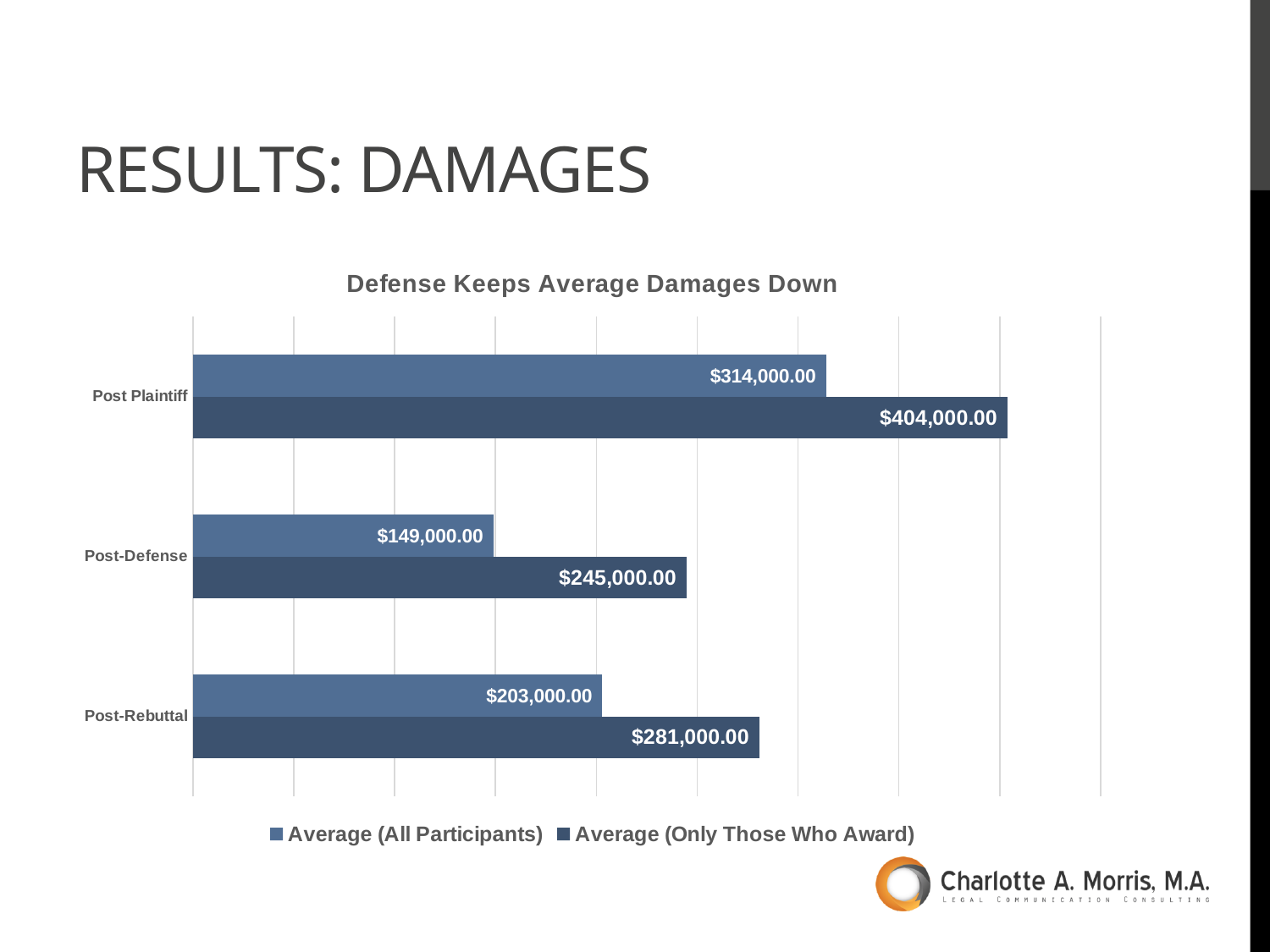
What is the difference between the Average (All Participants) values for Post-Rebuttal and Post-Defense? $54,000.00 What is the difference between the Average (Only Those Who Award) and Average (All Participants) values for Post Plaintiff? $90,000.00 Which category has the highest Average (Only Those Who Award) value? Post Plaintiff What is the Average (All Participants) value for Post-Rebuttal? $203,000.00 What is the Average (All Participants) value for Post Plaintiff? $314,000.00 What kind of chart is shown on the slide? Bar chart What is the title of the chart? Defense Keeps Average Damages Down What is the Average (Only Those Who Award) value for Post-Defense? $245,000.00 Which is larger: the Average (Only Those Who Award) value for Post-Rebuttal or for Post-Defense? Post-Rebuttal Which category has the lowest Average (All Participants) value? Post-Defense How many series does the legend list? 2 How many categories are shown on the chart? 3